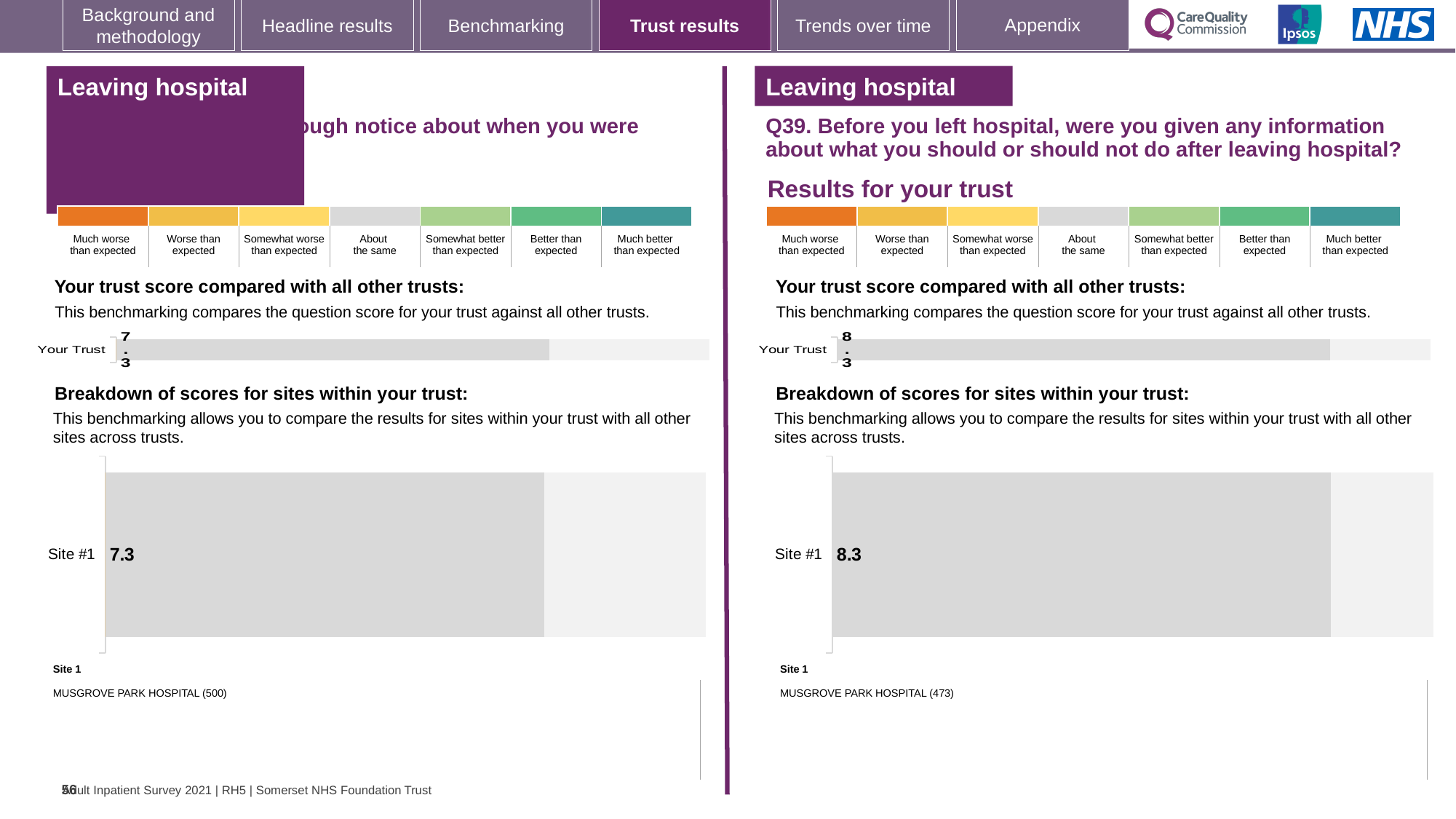
On the right-hand chart for Q39, is the Your Trust score greater or less than the Site #1 score, or are they equal? Equal On the right-hand side, which site is listed as Site 1 below the breakdown chart? MUSGROVE PARK HOSPITAL (473) Which is larger: the Site #1 score on the left-hand chart or the Site #1 score on the right-hand chart for Q39? Right-hand chart (Q39) On the left-hand chart, what is the score shown for Your Trust? 7.3 What is the difference between the Site #1 score on the right-hand chart for Q39 and the Site #1 score on the left-hand chart? 1.0 On the right-hand chart for Q39, what is the score shown for Site #1? 8.3 On the left-hand chart, what is the score shown for Site #1? 7.3 On the left-hand side, which site is listed as Site 1 below the breakdown chart? MUSGROVE PARK HOSPITAL (500) On the right-hand chart for Q39, what is the score shown for Your Trust? 8.3 How many sites are shown in the breakdown of scores chart on the right-hand side for Q39? 1 What kind of chart is used to show the breakdown of scores for sites within your trust? Bar chart